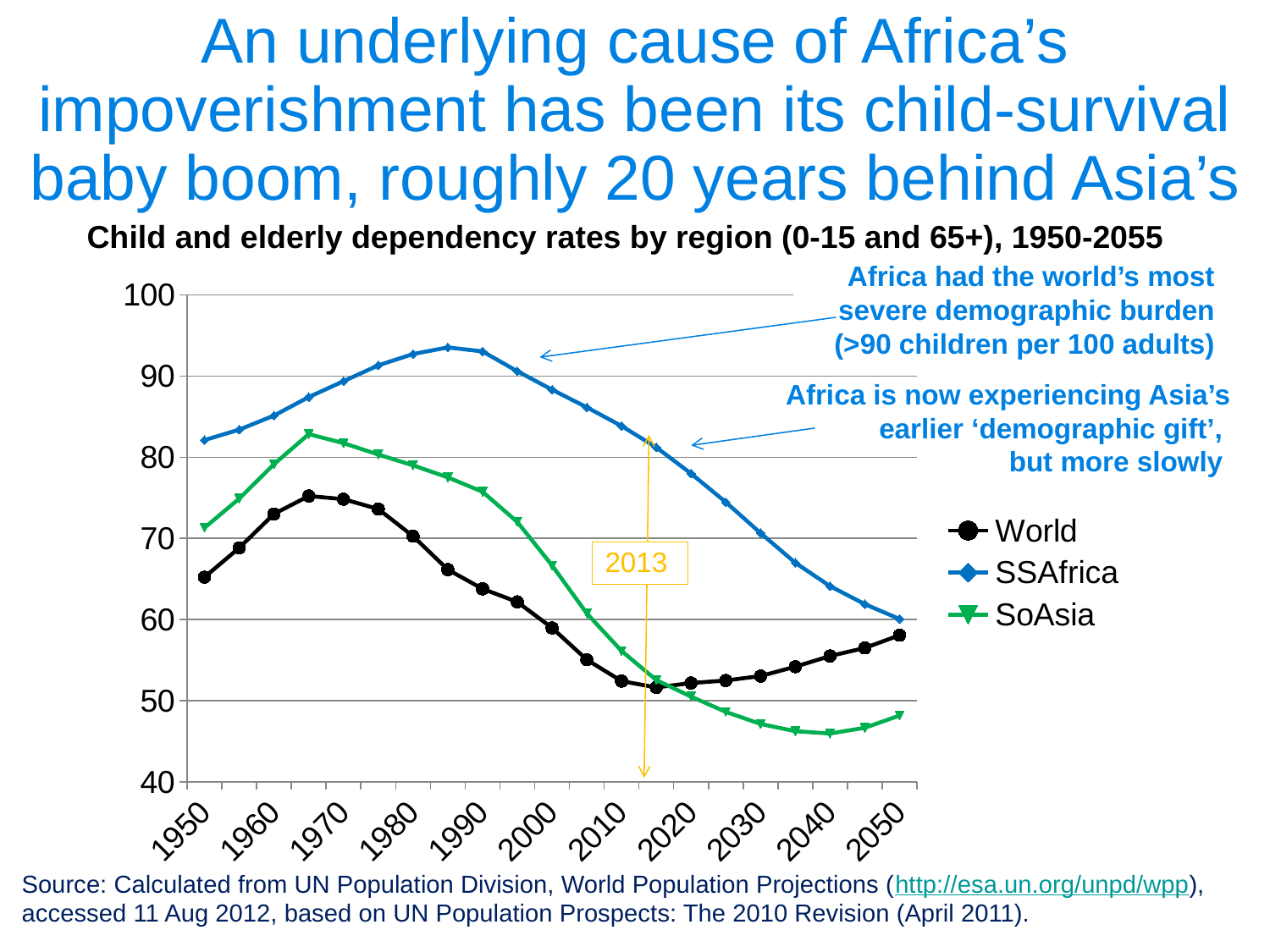
Is the value for SoAsia in 2040 greater or less than 50? less Is the value for World in 1950 greater or less than 60? greater Does the SSAfrica line rise or fall between 1990 and 2050? Fall In 2050, which is higher, the World line or the SoAsia line? World How many series does the chart's legend list? 3 What is the title of the chart? Child and elderly dependency rates by region (0-15 and 65+), 1950-2055 Is the value for SSAfrica in 1950 greater or less than 80? greater What kind of chart is shown on the slide? Line chart Does the World line rise or fall between 1950 and 1970? Rise Which three series are listed in the chart's legend? World, SSAfrica, SoAsia Which series has the highest values across the whole period shown? SSAfrica